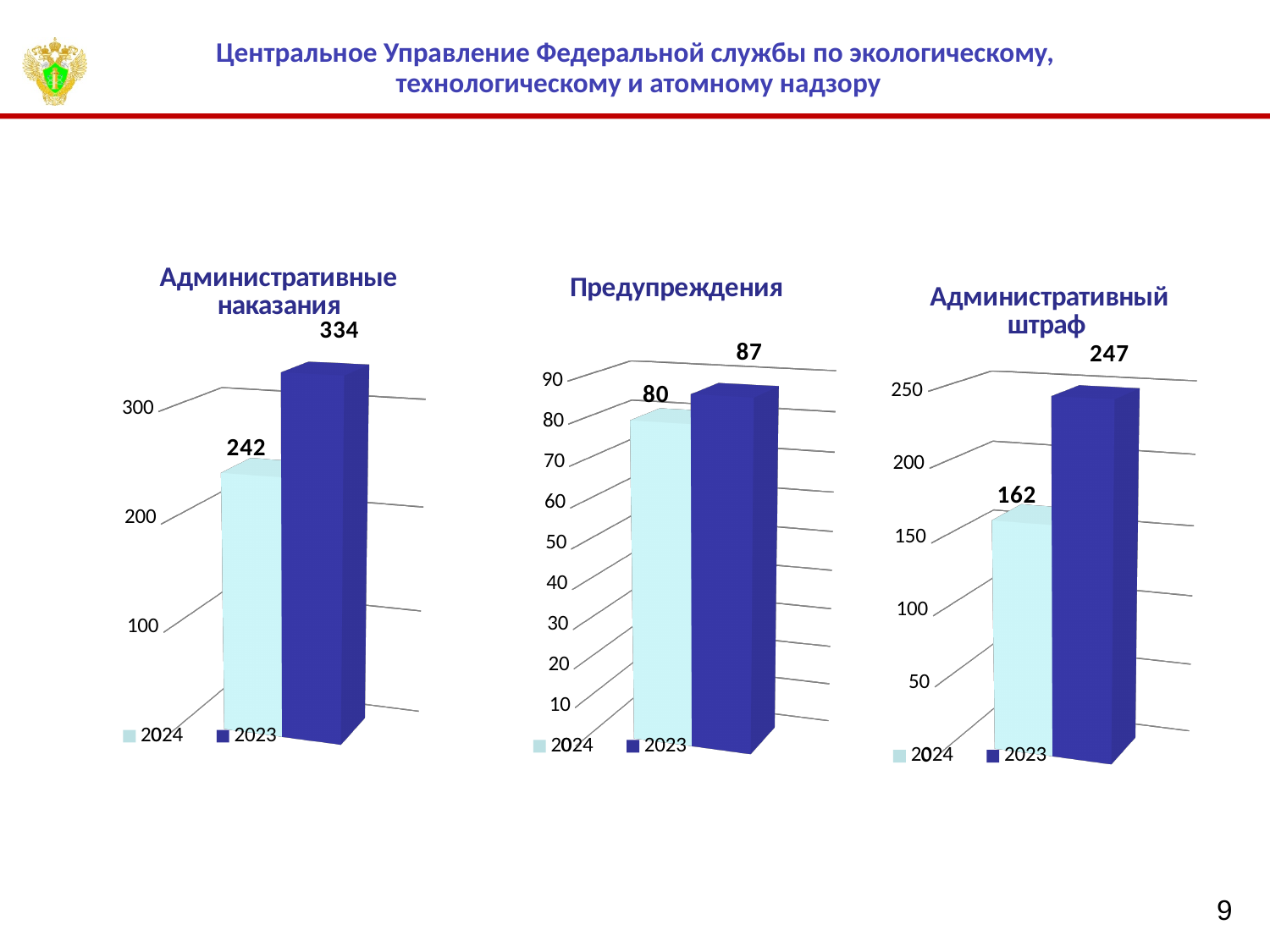
In the 'Предупреждения' chart, is the value for 2024 greater or less than 70? greater In the 'Административные наказания' chart, what is the value for 2024? 242 In the 'Административные наказания' chart, what is the difference between the 2023 and 2024 values? 92 What kind of chart is the 'Предупреждения' chart? bar chart In the 'Административный штраф' chart, which year has the lowest value? 2024 In the 'Предупреждения' chart, what is the value for 2023? 87 How many series does the legend of the 'Административные наказания' chart list? 2 In the 'Административный штраф' chart, what is the value for 2024? 162 In the 'Административный штраф' chart, what is the difference between the 2023 and 2024 values? 85 In the 'Административные наказания' chart, what is the value for 2023? 334 How many charts are shown on the slide? 3 In the 'Предупреждения' chart, which year has the larger value, 2024 or 2023? 2023